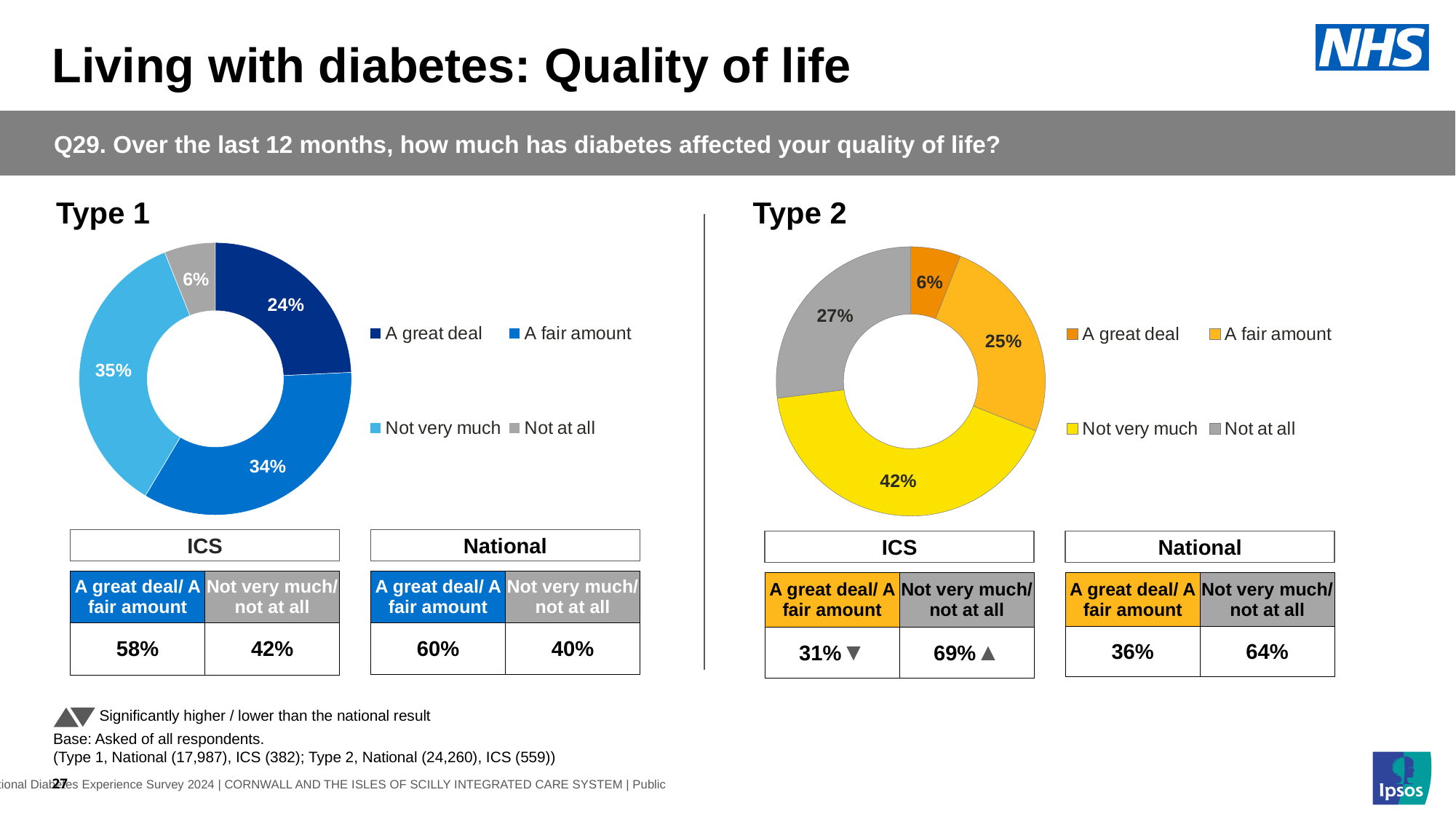
On the Type 2 chart, which category has the largest share? Not very much On the Type 1 chart, what is the difference between the 'A fair amount' share and the 'Not at all' share? 28% On the Type 1 chart, which category has the smallest share? Not at all On the Type 1 chart, what percentage of respondents said diabetes affected their quality of life 'A great deal'? 24% On the Type 2 chart, what percentage is shown for 'A fair amount'? 25% Which is larger: the 'A great deal' share on the Type 1 chart or the 'A great deal' share on the Type 2 chart? Type 1 On the Type 2 chart, what percentage is shown for 'Not at all'? 27% On the Type 2 chart, what is the difference between the 'Not very much' share and the 'A great deal' share? 36% What kind of chart is used for Type 1? Doughnut chart On the Type 1 chart, what percentage is shown for 'Not very much'? 35% How many categories does the Type 2 chart show? 4 On the Type 2 chart, which category has the smallest share? A great deal